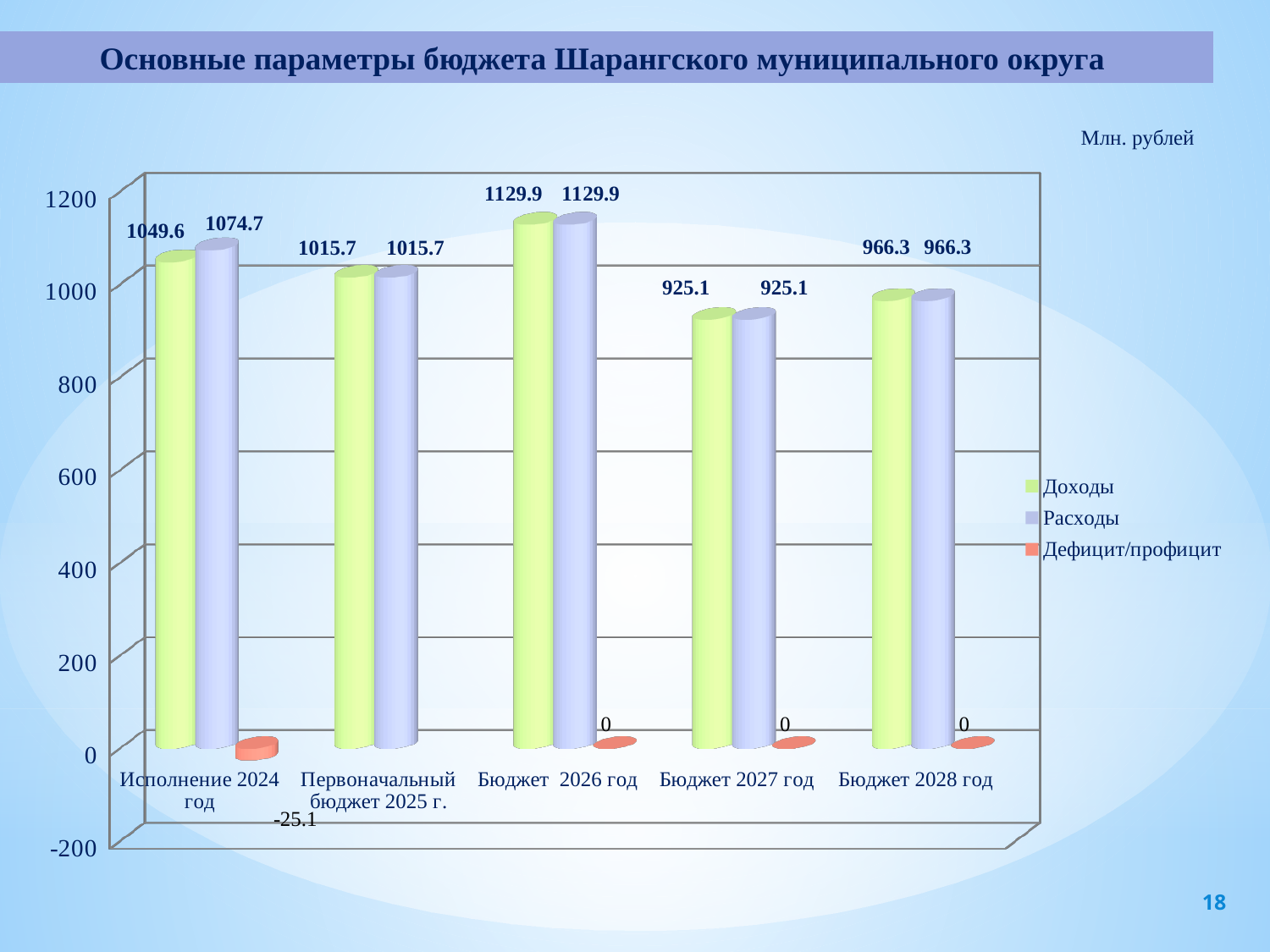
Which category has the lowest Расходы value? Бюджет 2027 год How many series does the legend list? 3 What kind of chart is shown on the slide? Bar chart What is the value of Расходы for Исполнение 2024 год? 1074.7 What is the value of Расходы for Бюджет 2028 год? 966.3 Which is larger for Исполнение 2024 год: Доходы or Расходы? Расходы What is the difference between Расходы and Доходы for Исполнение 2024 год? 25.1 Which category has the highest Доходы value? Бюджет 2026 год What is the value of Доходы for Исполнение 2024 год? 1049.6 What is the value of Доходы for Бюджет 2026 год? 1129.9 What is the value of Дефицит/профицит for Исполнение 2024 год? -25.1 How many categories are shown on the x axis? 5